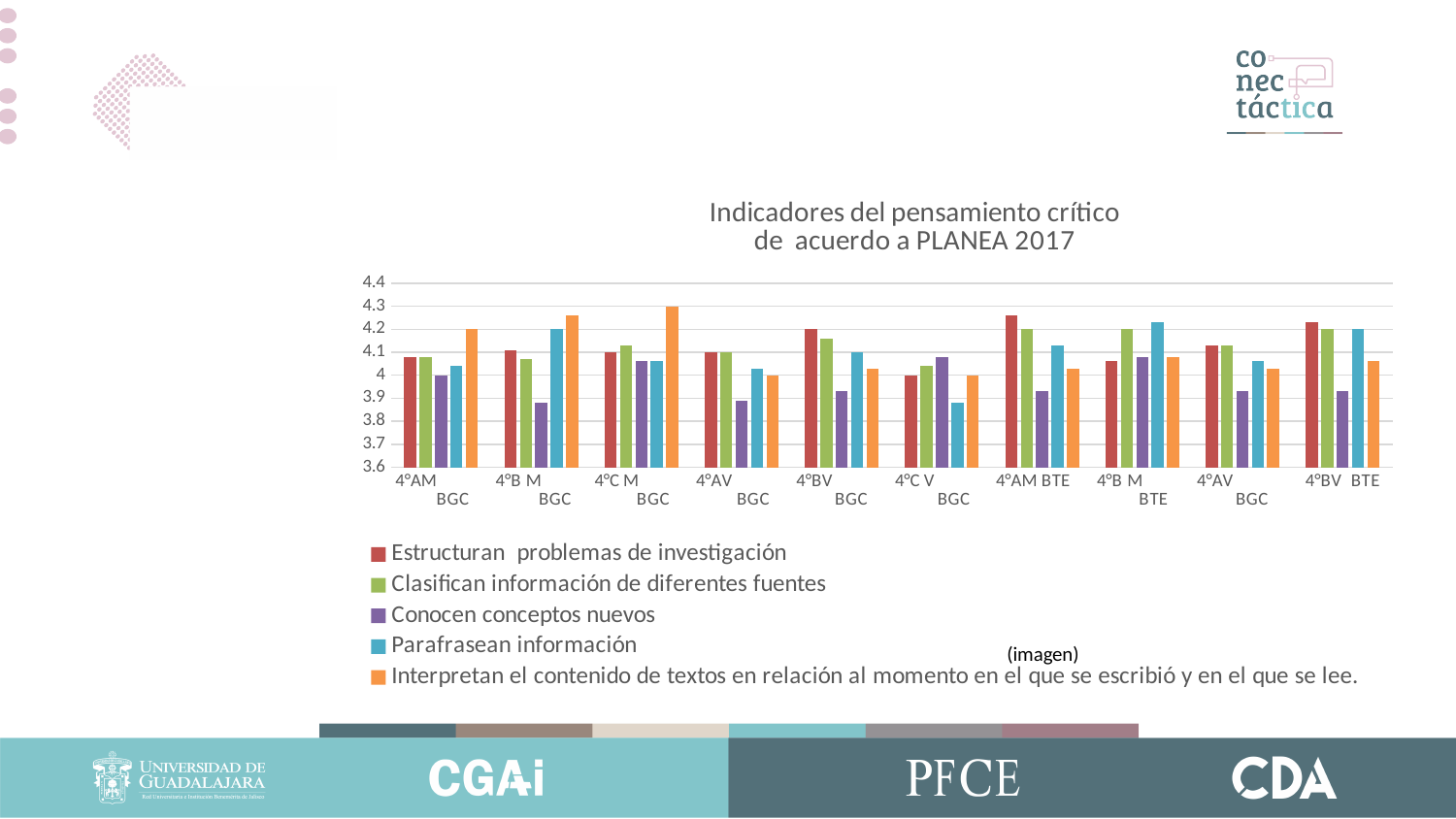
For 4°C M BGC, which is larger: 'Interpretan el contenido de textos...' or 'Conocen conceptos nuevos'? Interpretan el contenido de textos en relación al momento en el que se escribió y en el que se lee. Is the value of 'Estructuran problemas de investigación' for 4°AM BTE greater or less than 4.1? greater Which is larger: 'Parafrasean información' for 4°B M BTE or for 4°AV BGC (the second 4°AV BGC group)? 4°B M BTE What kind of chart is shown on the slide? bar chart How many series does the legend list? 5 For 4°C M BGC, which series has the highest value? Interpretan el contenido de textos en relación al momento en el que se escribió y en el que se lee. What is the title of the chart? Indicadores del pensamiento crítico de acuerdo a PLANEA 2017 Is the value of 'Parafrasean información' for 4°C V BGC greater or less than 4? less Is the value of 'Conocen conceptos nuevos' for 4°B M BGC greater or less than 4? less How many groups (categories) are shown along the x axis? 10 For 4°BV BGC, which series has the lowest value? Conocen conceptos nuevos